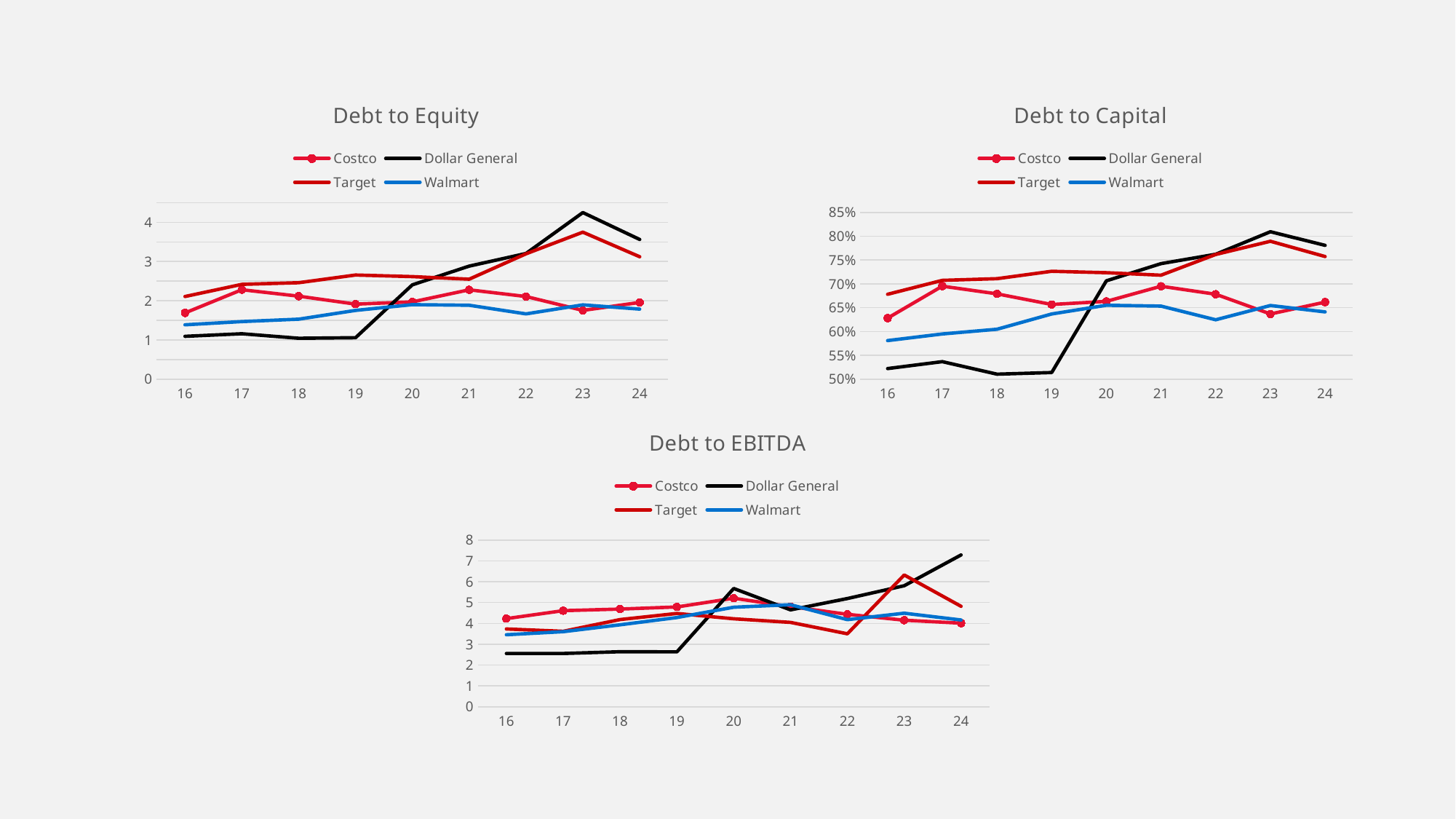
In the Debt to Capital chart, which is larger in 16, Target or Walmart? Target In the Debt to Capital chart, which series has the lowest value in 19? Dollar General In the Debt to Capital chart, is the value for Dollar General in 18 greater or less than 55%? less How many series does the legend of the Debt to Capital chart list? 4 How many years are shown on the x axis of the Debt to EBITDA chart? 9 In the Debt to EBITDA chart, is the value for Dollar General in 24 greater or less than 7? greater In the Debt to Equity chart, which series has the highest value in 24? Dollar General In the Debt to EBITDA chart, does the Dollar General line rise or fall from 16 to 24? rise In the Debt to Equity chart, which series has the lowest value in 16? Dollar General In the Debt to Equity chart, is the value for Dollar General in 23 greater or less than 4? greater Which series is drawn in blue in the Debt to EBITDA chart? Walmart What kind of chart is the Debt to Equity chart? line chart